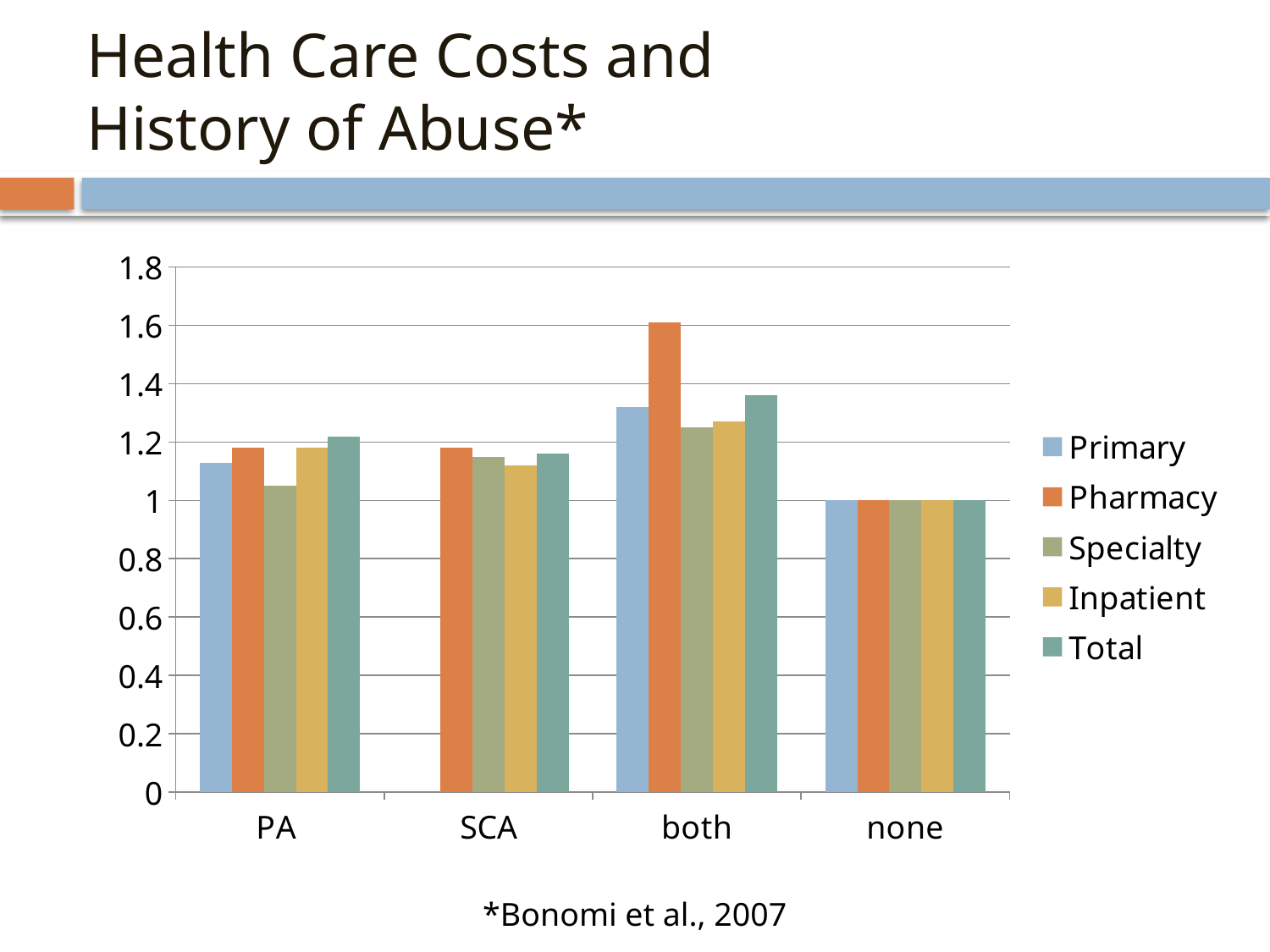
How many series does the legend list? 5 Is the Pharmacy value for 'both' greater or less than 1.4? greater In the 'both' category, which is larger: the Pharmacy bar or the Primary bar? Pharmacy Is the Primary value for PA greater or less than 1.2? less What kind of chart is shown on the slide? bar chart Which series has the lowest bar in the PA category? Specialty Is the Total value for 'both' greater or less than 1.2? greater What is the value of the Primary bar for the 'none' category? 1 Which series is listed last in the legend? Total What is the value of the Total bar for the 'none' category? 1 Which category has the highest Pharmacy bar? both How many categories are shown on the x axis? 4